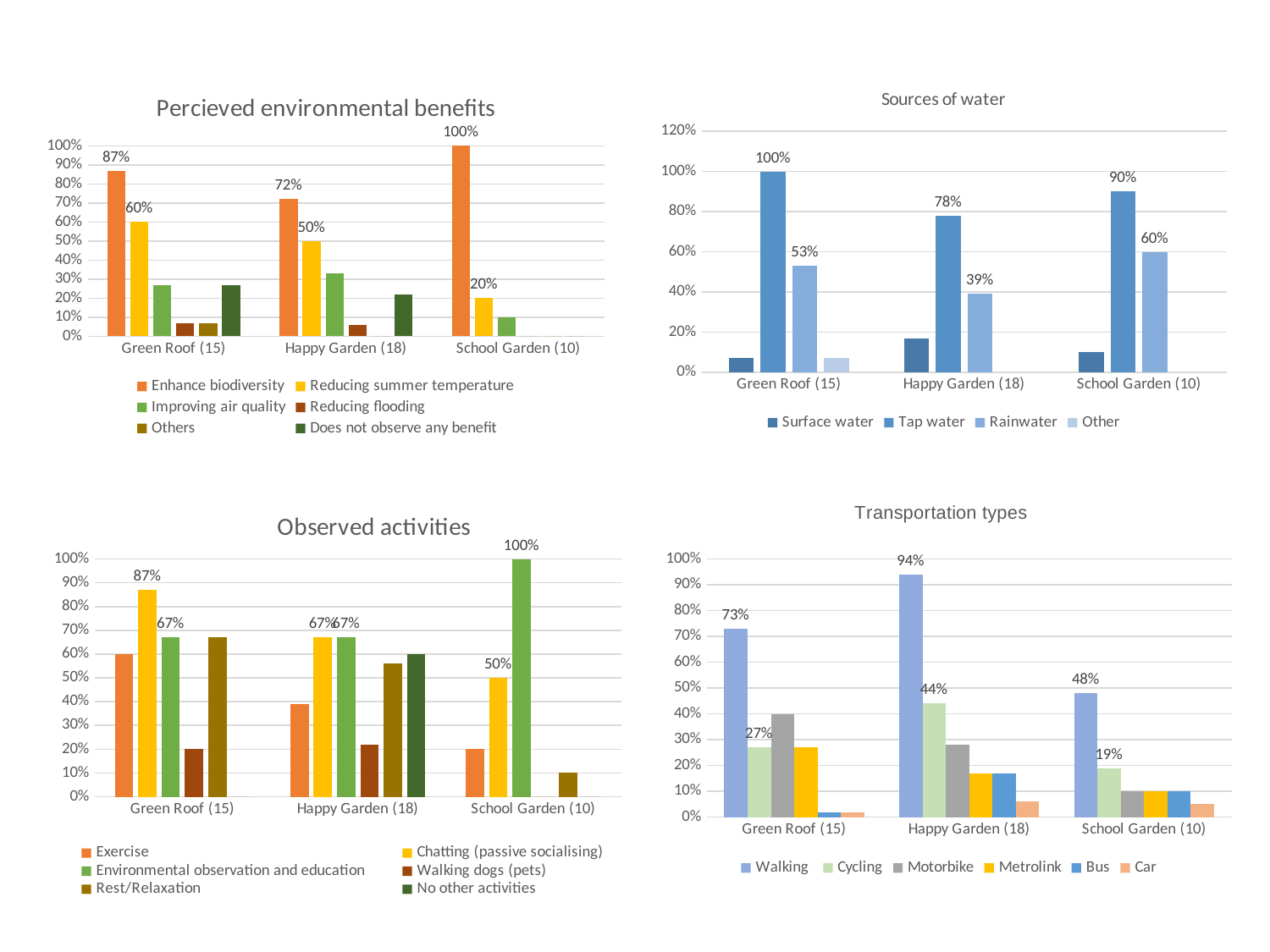
In the 'Observed activities' chart, what is the value for Environmental observation and education at School Garden (10)? 100% In the 'Transportation types' chart, what is the value for Walking at Happy Garden (18)? 94% In the 'Sources of water' chart, what is the value for Rainwater at Happy Garden (18)? 39% In the 'Observed activities' chart, which is larger at Green Roof (15): Chatting (passive socialising) or Environmental observation and education? Chatting (passive socialising) In the 'Percieved environmental benefits' chart, which site has the highest value for Enhance biodiversity? School Garden (10) In the 'Sources of water' chart, is the value for Surface water at Green Roof (15) greater or less than 20%? less In the 'Percieved environmental benefits' chart, what is the difference between Enhance biodiversity and Reducing summer temperature at Happy Garden (18)? 22% In the 'Sources of water' chart, which site has the lowest value for Tap water? Happy Garden (18) In the 'Transportation types' chart, what is the difference between Walking and Cycling at School Garden (10)? 29% What type of chart is the 'Transportation types' chart? Bar chart In the 'Sources of water' chart, how many series does the legend list? 4 In the 'Percieved environmental benefits' chart, what is the value for Enhance biodiversity at Green Roof (15)? 87%